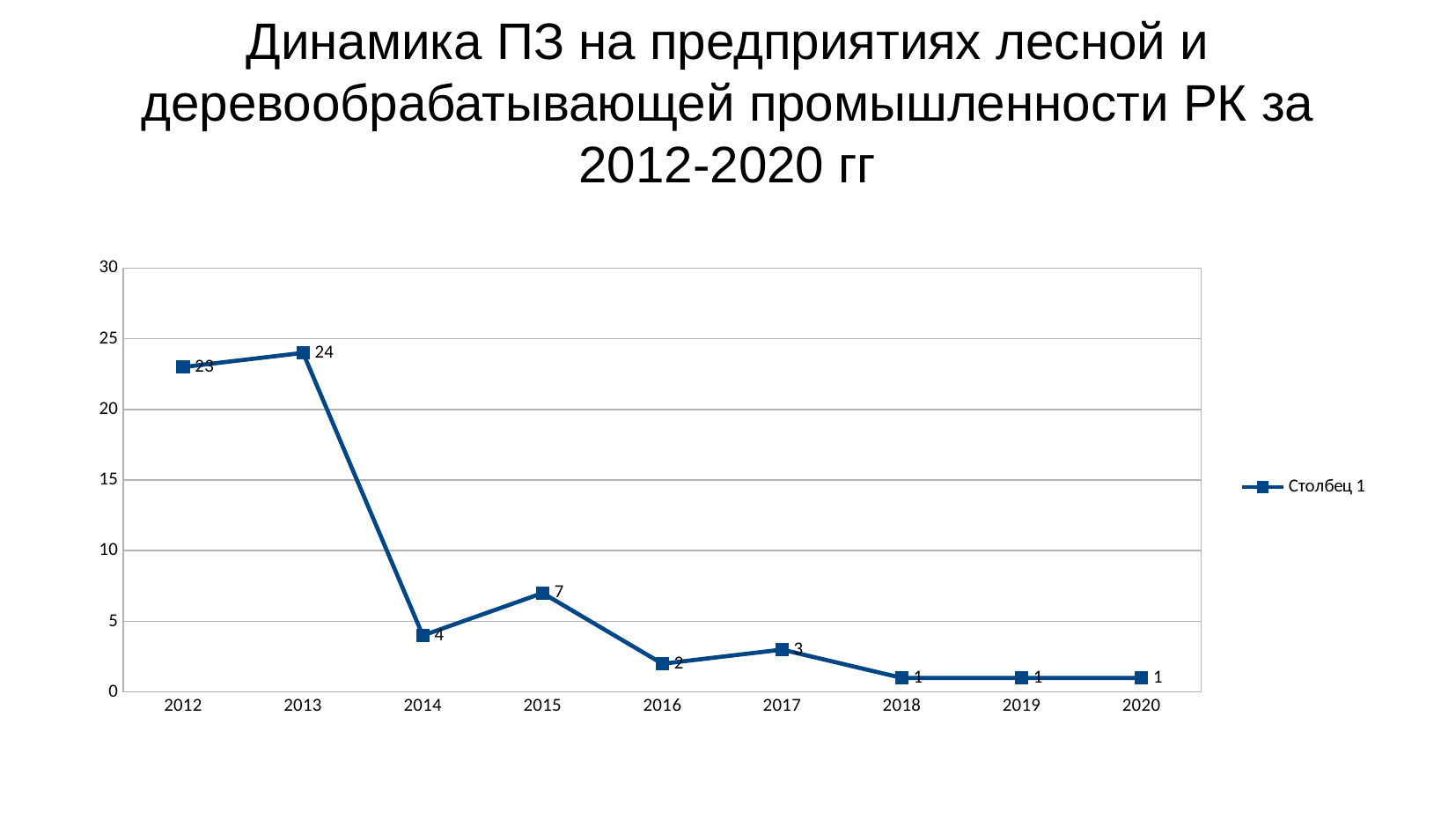
How many years are plotted on the x axis? 9 What is the value for 2015? 7 What kind of chart is shown? line chart What is the name of the series in the legend? Столбец 1 How many series does the legend list? 1 Do the values generally rise or fall from 2012 to 2020? fall Is the value for 2012 greater or less than 20? greater What is the value for 2013? 24 Which is larger, the value for 2014 or the value for 2016? 2014 What is the value for 2017? 3 What is the difference between the values for 2013 and 2014? 20 Which year has the highest value? 2013